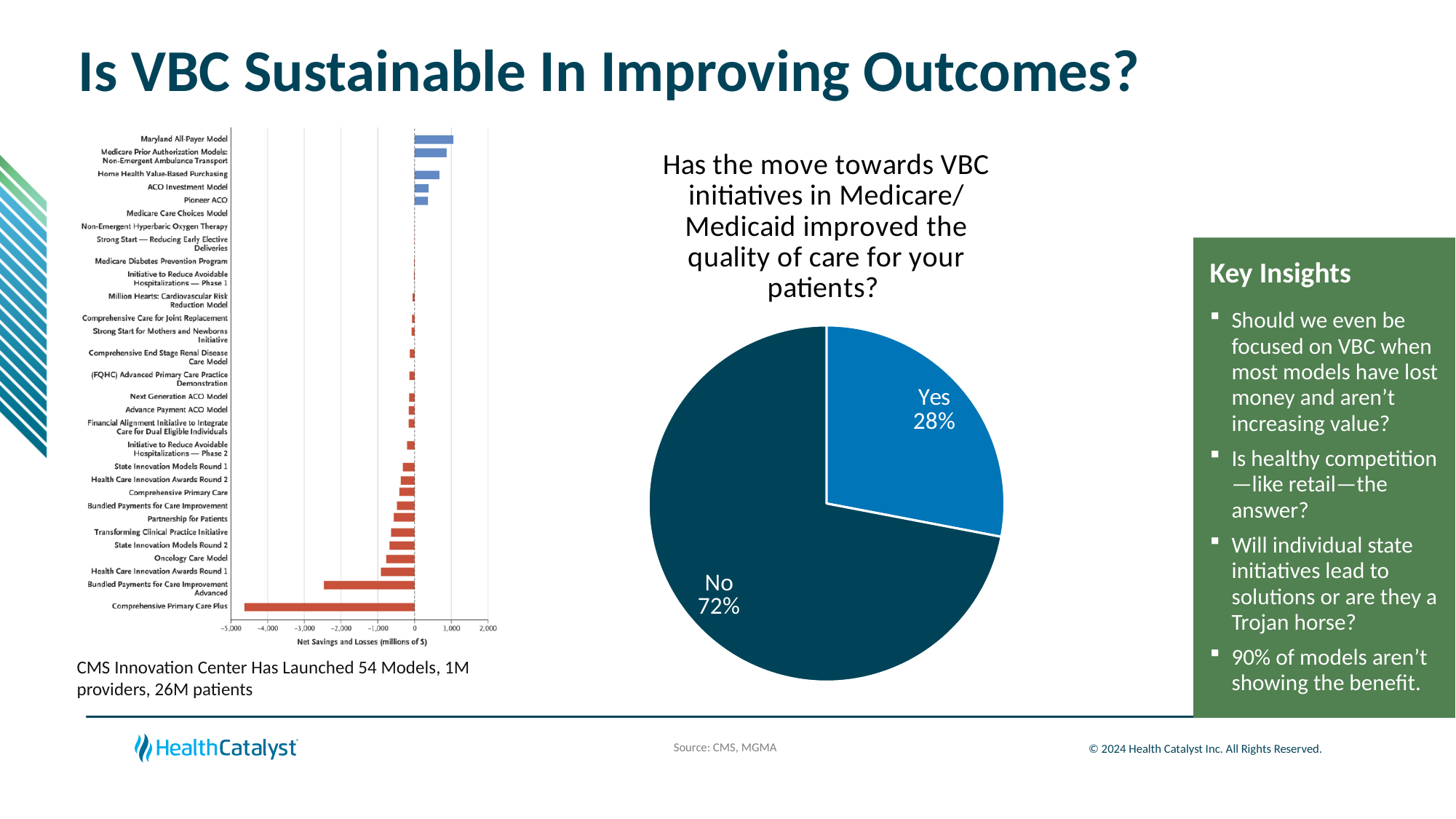
On the pie chart, what percentage of respondents answered No? 72% What kind of chart is the chart on the left of the slide? Bar chart What is the x-axis label of the left bar chart? Net Savings and Losses (millions of $) On the pie chart, what percentage of respondents answered Yes? 28% On the pie chart, what is the difference in percentage points between the No and Yes shares? 44 percentage points What kind of chart is the chart on the right of the slide? Pie chart On the left bar chart, is the value for Comprehensive Primary Care Plus greater or less than -4,000? less On the left bar chart, is the value for Bundled Payments for Care Improvement Advanced greater or less than -2,000? less On the pie chart, which response has the larger share? No How many slices does the pie chart on the right have? 2 On the left bar chart, which model has the highest net savings? Maryland All-Payer Model On the left bar chart, which model has the largest net loss? Comprehensive Primary Care Plus